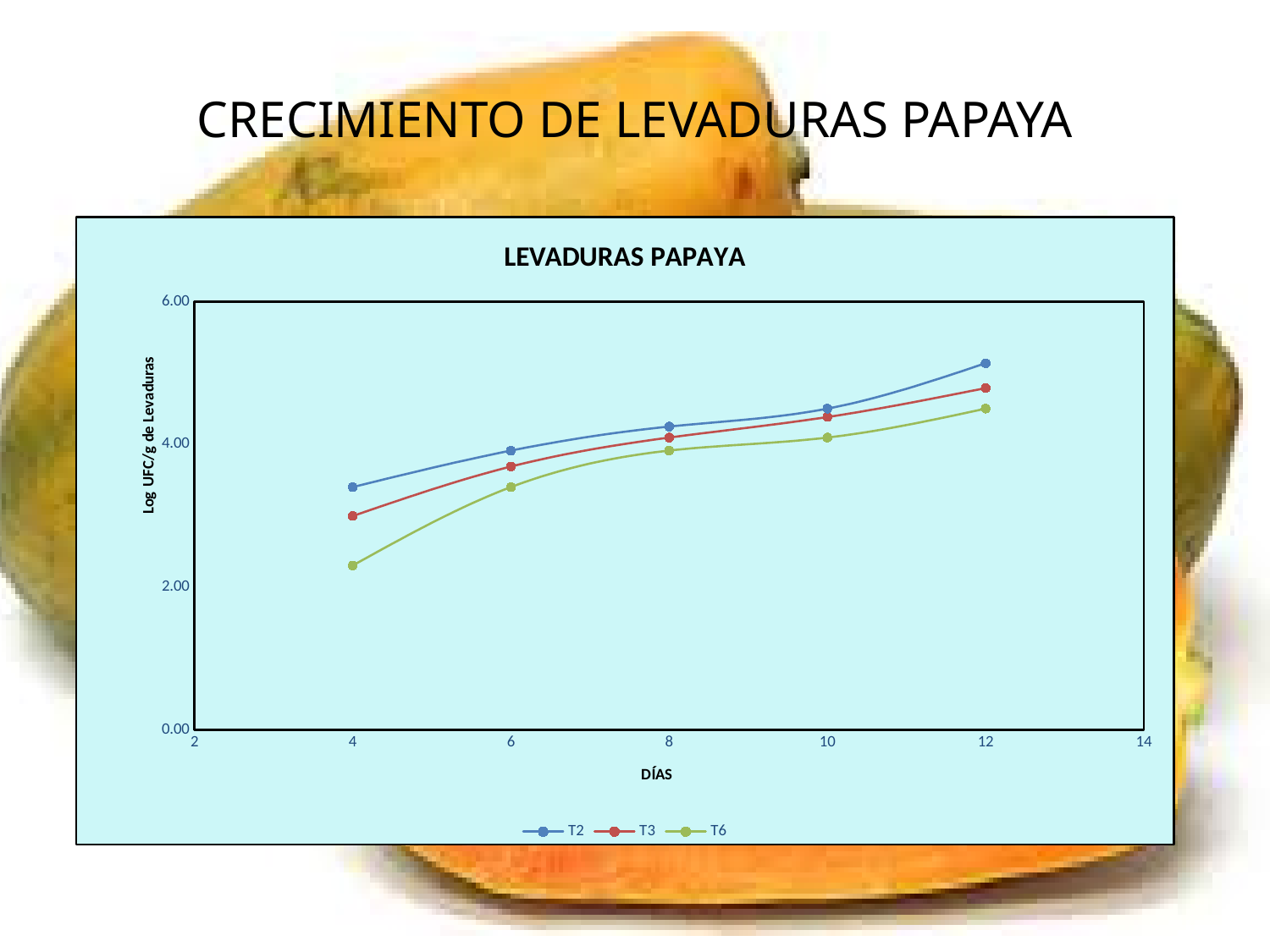
Is the value for T6 at day 4 greater or less than 4.00? less What is the title of the chart? LEVADURAS PAPAYA Is the value for T6 at day 4 greater or less than 2.00? greater How many data points are plotted for the T2 series? 5 Is the value for T3 at day 4 greater or less than 4.00? less What kind of chart is shown on the slide? line chart At day 4, which series has the lowest value? T6 At day 12, which series has the highest value? T2 Do the values for T6 rise or fall as the days increase along the x axis? rise At day 4, which is larger, the value for T2 or the value for T6? T2 How many series does the legend list? 3